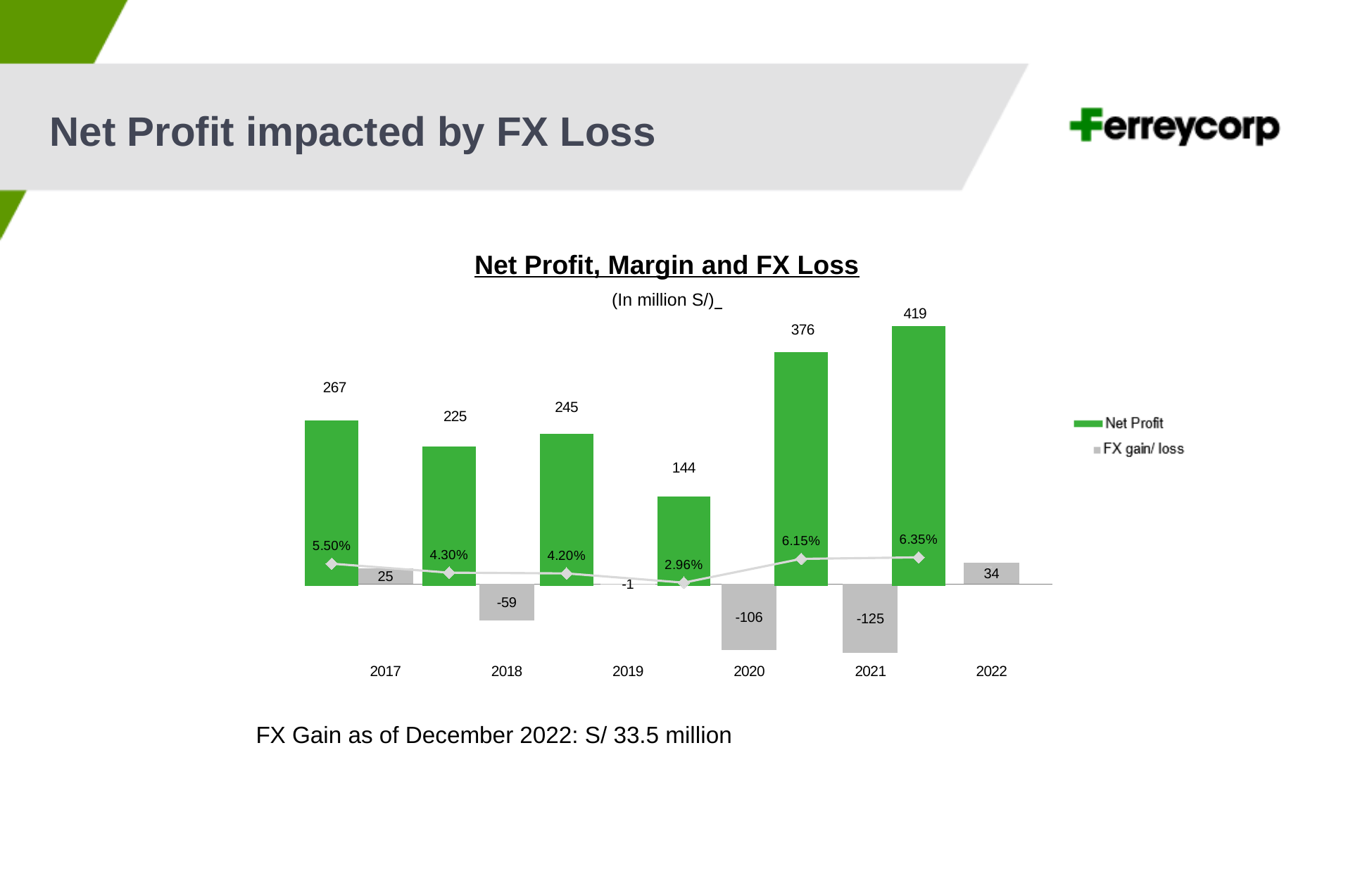
What kind of chart is used to show Net Profit and FX gain/loss? Bar chart What is the title of the chart? Net Profit, Margin and FX Loss What is the difference between the Net Profit for 2021 and 2020? 232 What is the FX gain/loss value for 2020? -106 How many years are shown on the x axis? 6 Which year has the highest Net Profit? 2022 Which year has the lowest Net Profit? 2020 Does the Net Profit rise or fall from 2019 to 2021? Rise What is the Net Profit value for 2021? 376 Which is larger, the Net Profit for 2017 or for 2018? 2017 What margin percentage is shown for 2019? 4.20% How many series does the legend list? 2